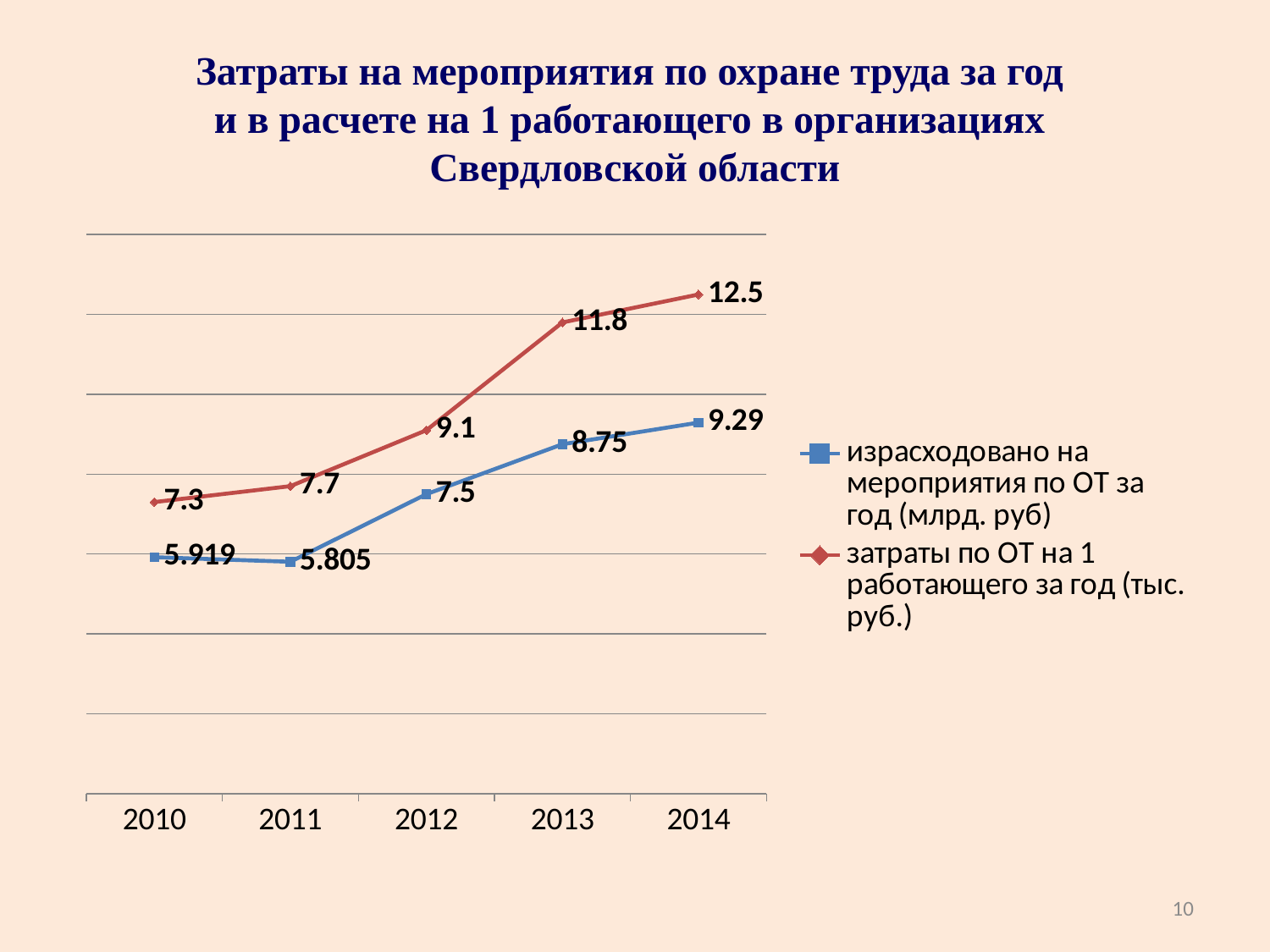
Does 'затраты по ОТ на 1 работающего за год (тыс. руб.)' rise or fall from 2010 to 2014? rise What colour is the line for 'израсходовано на мероприятия по ОТ за год (млрд. руб)'? blue In which year is 'затраты по ОТ на 1 работающего за год (тыс. руб.)' highest? 2014 How many series does the legend list? 2 What is the value of 'затраты по ОТ на 1 работающего за год (тыс. руб.)' in 2013? 11.8 In which year is 'израсходовано на мероприятия по ОТ за год (млрд. руб)' lowest? 2011 What type of chart is shown on the slide? line chart Which series has the larger value in 2013, 'израсходовано на мероприятия по ОТ за год (млрд. руб)' or 'затраты по ОТ на 1 работающего за год (тыс. руб.)'? затраты по ОТ на 1 работающего за год (тыс. руб.) What is the value of 'израсходовано на мероприятия по ОТ за год (млрд. руб)' in 2010? 5.919 What is the difference between the 2014 and 2010 values of 'затраты по ОТ на 1 работающего за год (тыс. руб.)'? 5.2 What is the value of 'израсходовано на мероприятия по ОТ за год (млрд. руб)' in 2012? 7.5 How many years are plotted along the x axis? 5